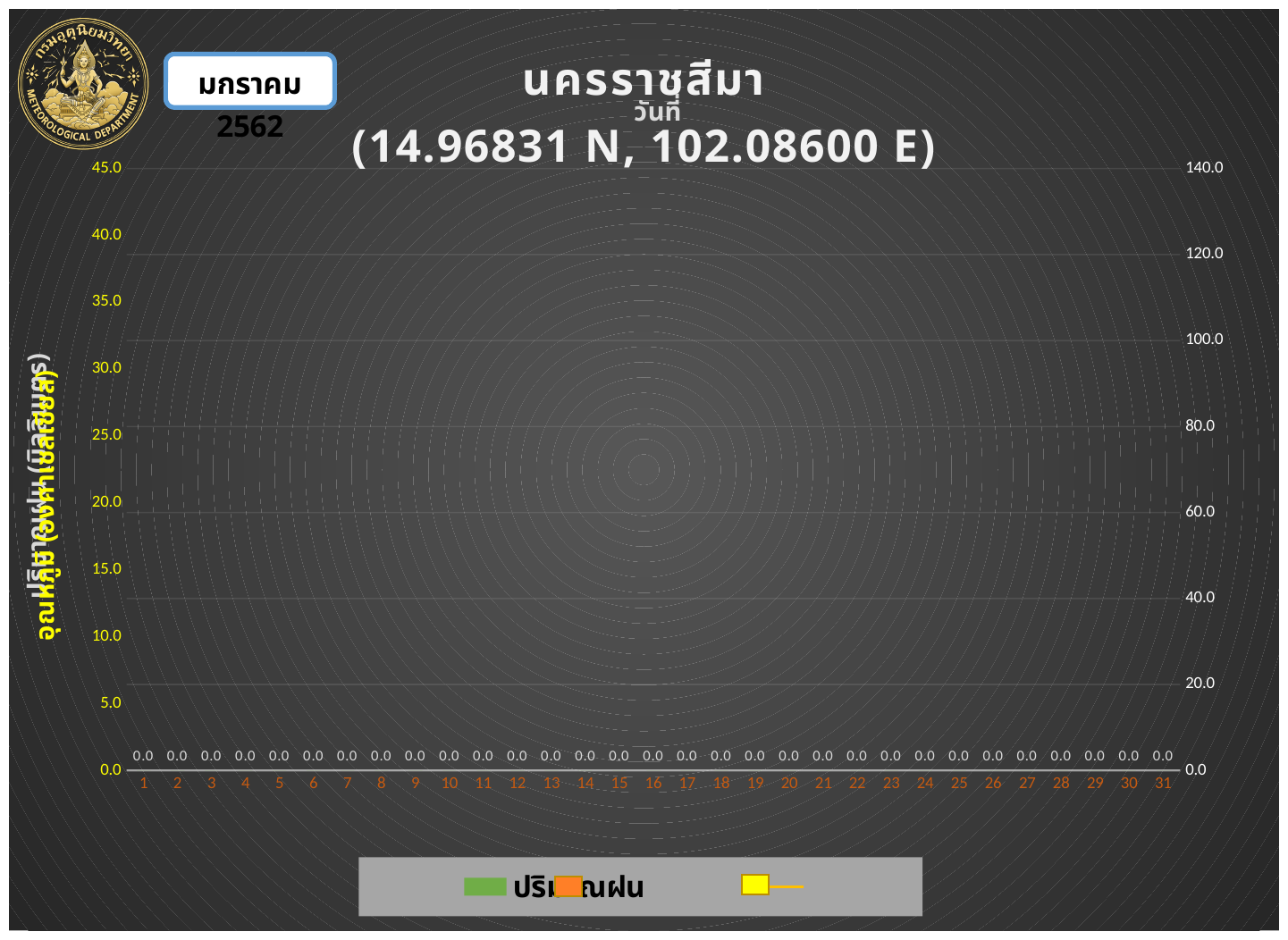
Is the value for day 20 greater or less than 20.0 on the right axis? less How many days (categories) are shown along the x axis of the chart? 31 Do the data labels rise, fall, or stay the same from day 1 to day 31? stay the same What is the data label shown for day 15 on the chart? 0.0 What is the data label shown for day 1 on the chart? 0.0 What is the highest tick value shown on the left vertical axis of the chart? 45.0 What is the difference between the data labels for day 5 and day 25? 0.0 What is the highest tick value shown on the right vertical axis of the chart? 140.0 Is the value for day 10 greater or less than 5.0 on the left axis? less What is the data label shown for day 31 on the chart? 0.0